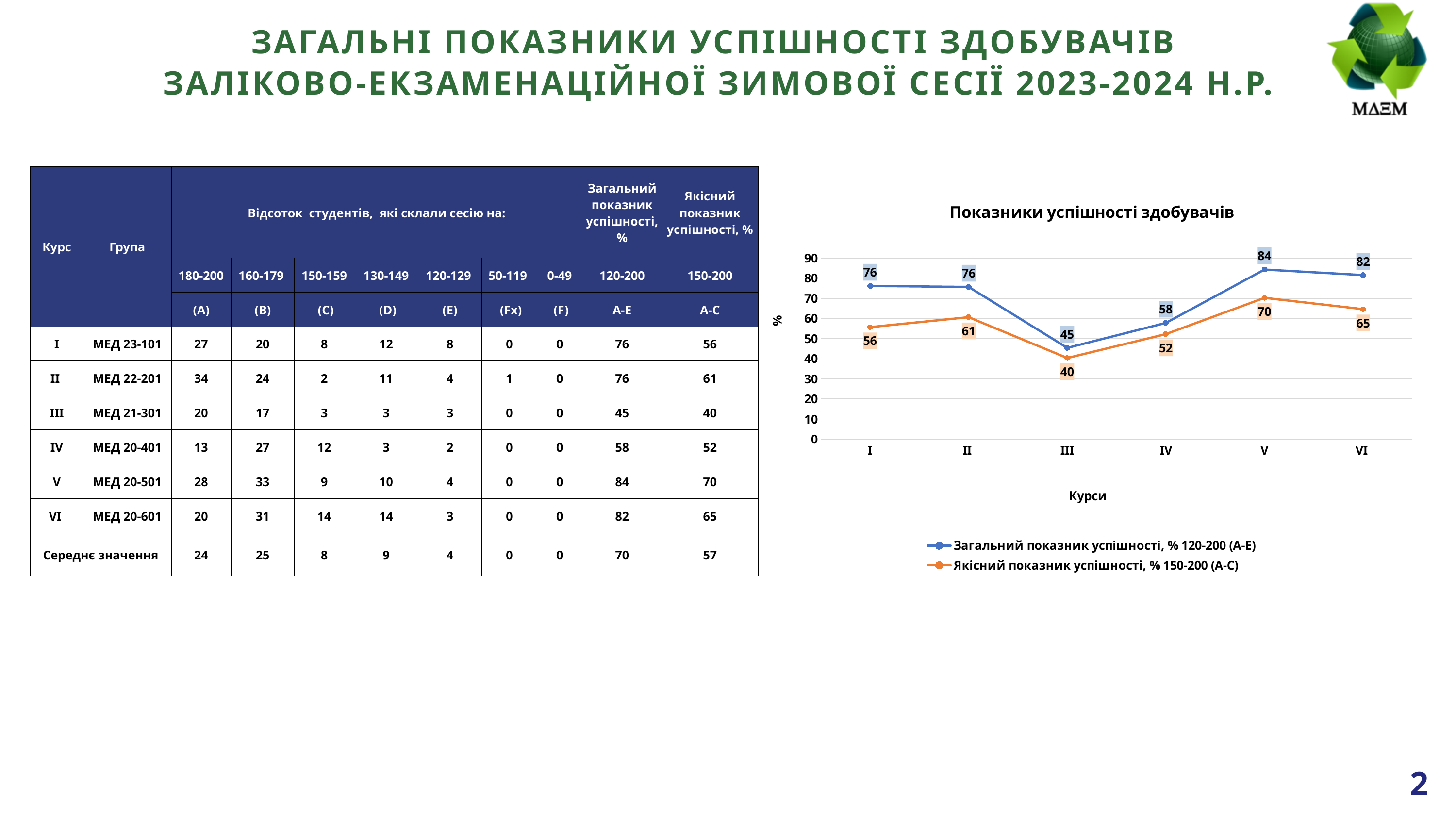
What is the difference between 'Загальний показник успішності' and 'Якісний показник успішності' for course I? 20 Which is larger: 'Якісний показник успішності' for course II or for course IV? course II Does 'Загальний показник успішності' rise or fall from course III to course V? rise Which course has the highest value for 'Загальний показник успішності'? V What is the value of 'Якісний показник успішності' for course III? 40 How many courses (categories) are plotted along the x axis of the chart? 6 What type of chart is shown on the slide? line chart Which course has the lowest value for 'Якісний показник успішності'? III What is the value of 'Загальний показник успішності' for course V? 84 How many series does the chart legend list? 2 Which colour is used for the 'Якісний показник успішності' line in the chart? orange What is the title of the chart on the slide? Показники успішності здобувачів